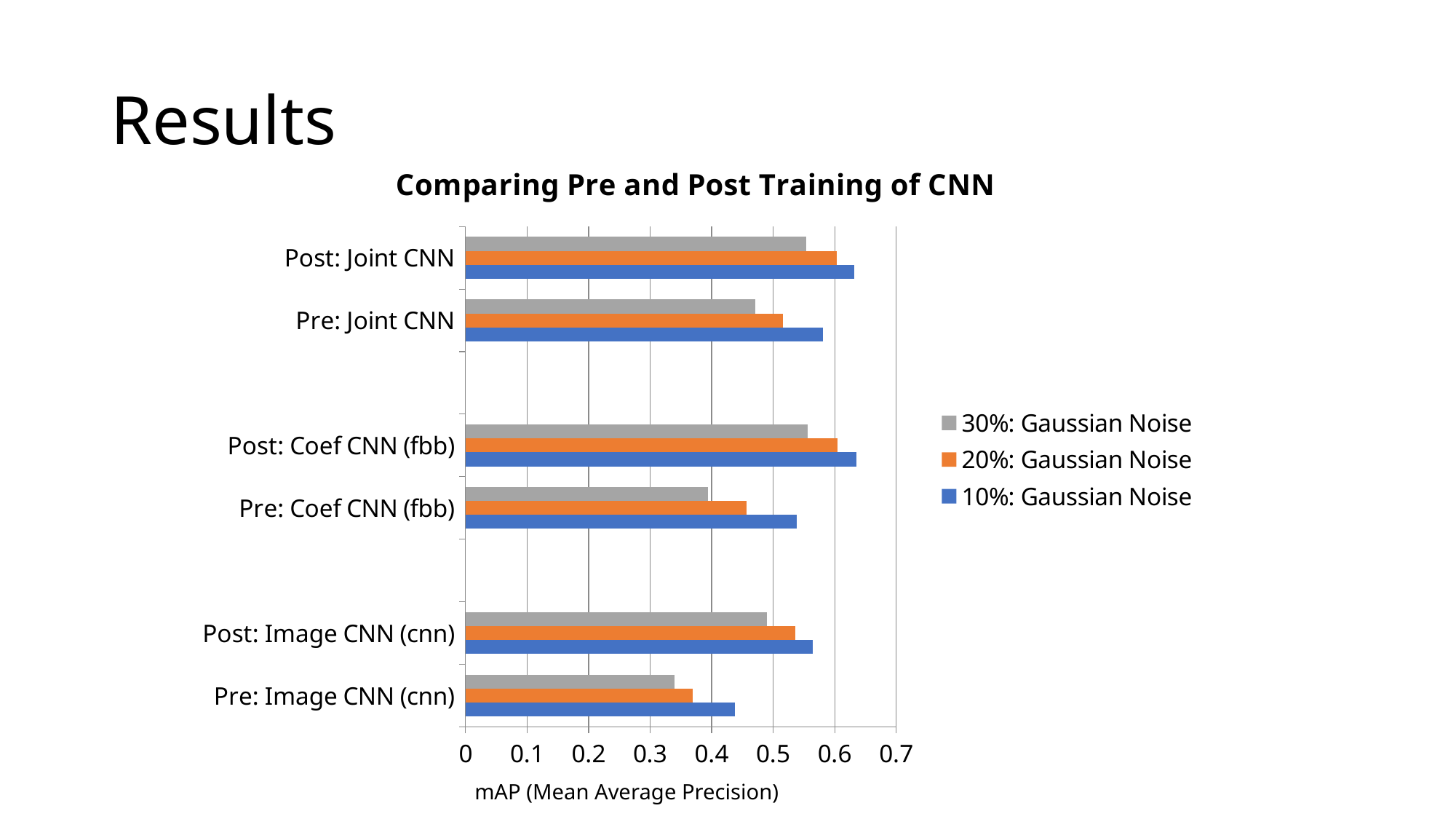
What is the title of the chart? Comparing Pre and Post Training of CNN How many categories are plotted on the y axis? 6 Is the 20%: Gaussian Noise value for Pre: Image CNN (cnn) greater or less than 0.4? less How many series does the legend list? 3 What kind of chart is shown on the slide? bar chart Which category has the lowest 30%: Gaussian Noise value? Pre: Image CNN (cnn) Is the 10%: Gaussian Noise value for Pre: Joint CNN greater or less than 0.5? greater For 20%: Gaussian Noise, which is larger: Pre: Coef CNN (fbb) or Pre: Image CNN (cnn)? Pre: Coef CNN (fbb) Is the 10%: Gaussian Noise value for Pre: Image CNN (cnn) greater or less than 0.4? greater For 10%: Gaussian Noise, which is larger: Post: Joint CNN or Pre: Joint CNN? Post: Joint CNN What is the label of the x axis? mAP (Mean Average Precision)